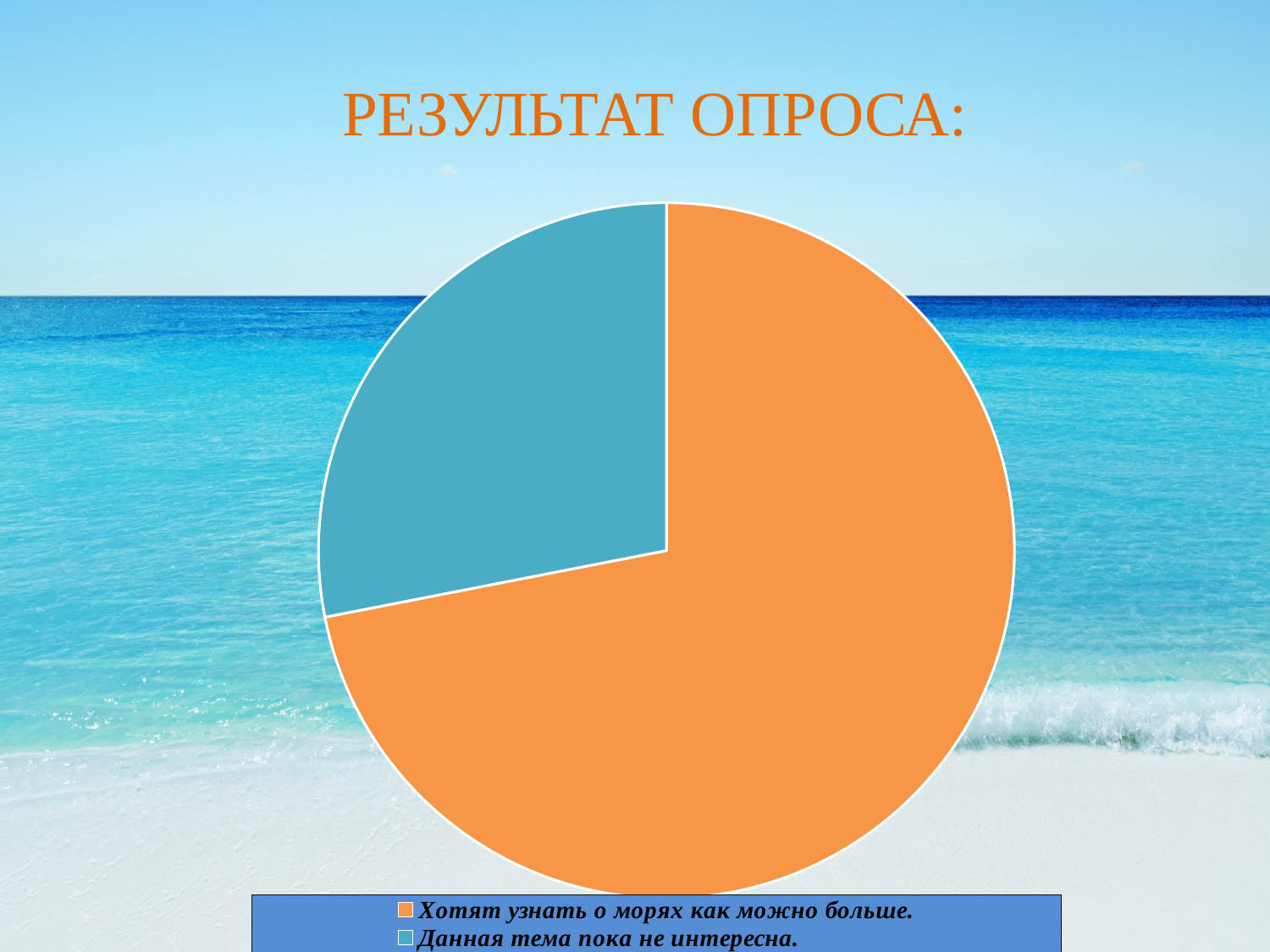
Which is larger in the pie chart: the slice for "Хотят узнать о морях как можно больше." or the slice for "Данная тема пока не интересна."? Хотят узнать о морях как можно больше. Does the slice "Хотят узнать о морях как можно больше." take up more or less than half of the pie chart? more Which slice of the pie chart is the largest? Хотят узнать о морях как можно больше. How many slices does the pie chart have? 2 What kind of chart is shown on the slide? pie chart What is the title of the slide containing the pie chart? РЕЗУЛЬТАТ ОПРОСА: What colour is the slice for "Данная тема пока не интересна." in the pie chart? teal (blue) How many entries does the legend of the pie chart list? 2 Which slice of the pie chart is the smallest? Данная тема пока не интересна.